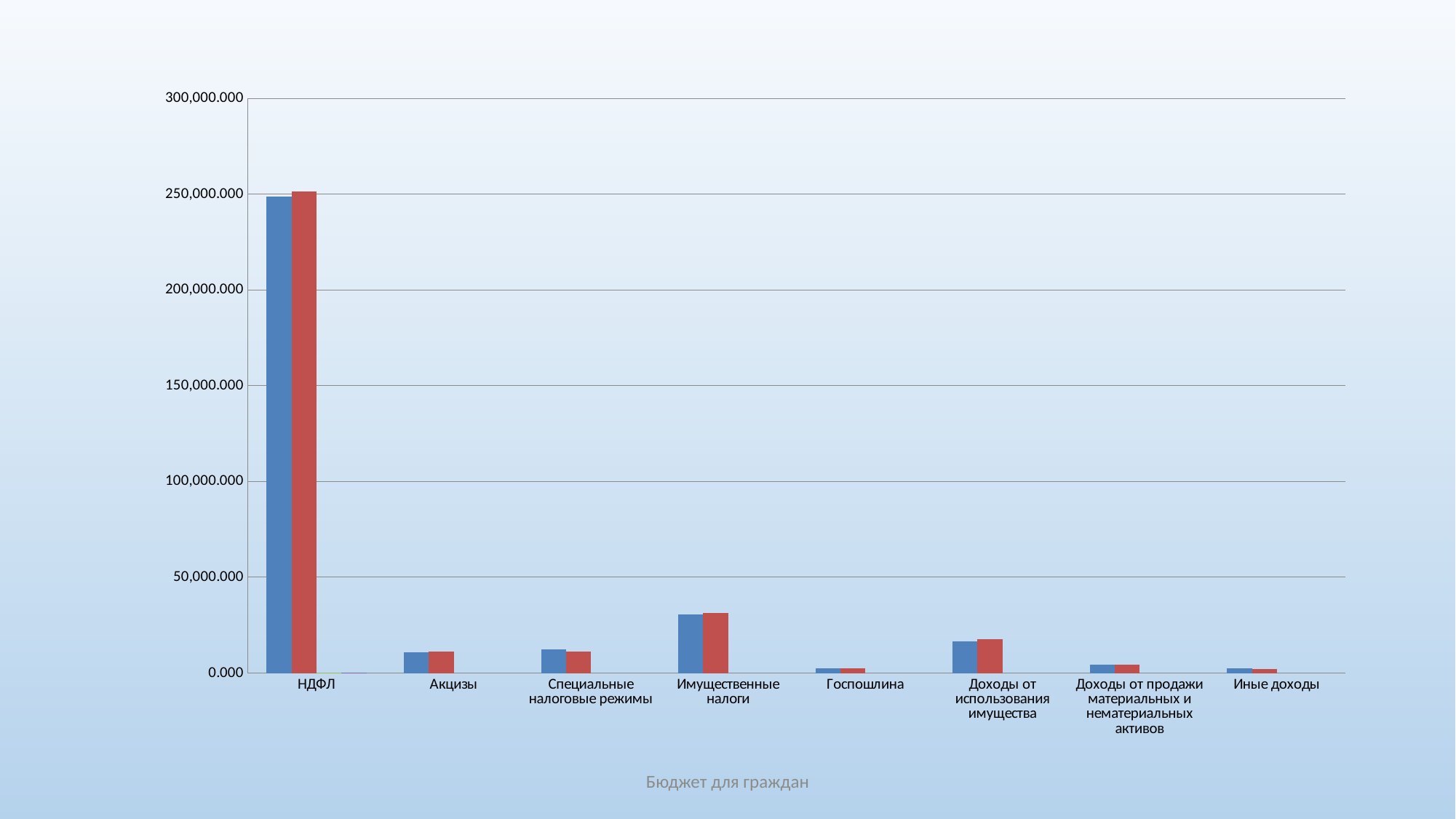
What kind of chart is shown on the slide? bar chart Is the red bar for НДФЛ greater or less than 300,000.000? less Which category has larger bars, НДФЛ or Имущественные налоги? НДФЛ Is the blue bar for Имущественные налоги greater or less than 50,000.000? less Which category has the highest bars in the chart? НДФЛ What text appears below the chart on the slide? Бюджет для граждан Which category has larger bars, Имущественные налоги or Акцизы? Имущественные налоги Is the red bar for Акцизы greater or less than 50,000.000? less Which category has larger bars, Доходы от использования имущества or Госпошлина? Доходы от использования имущества How many categories are shown along the x axis of the chart? 8 What two colours are used for the bars in the chart? blue and red